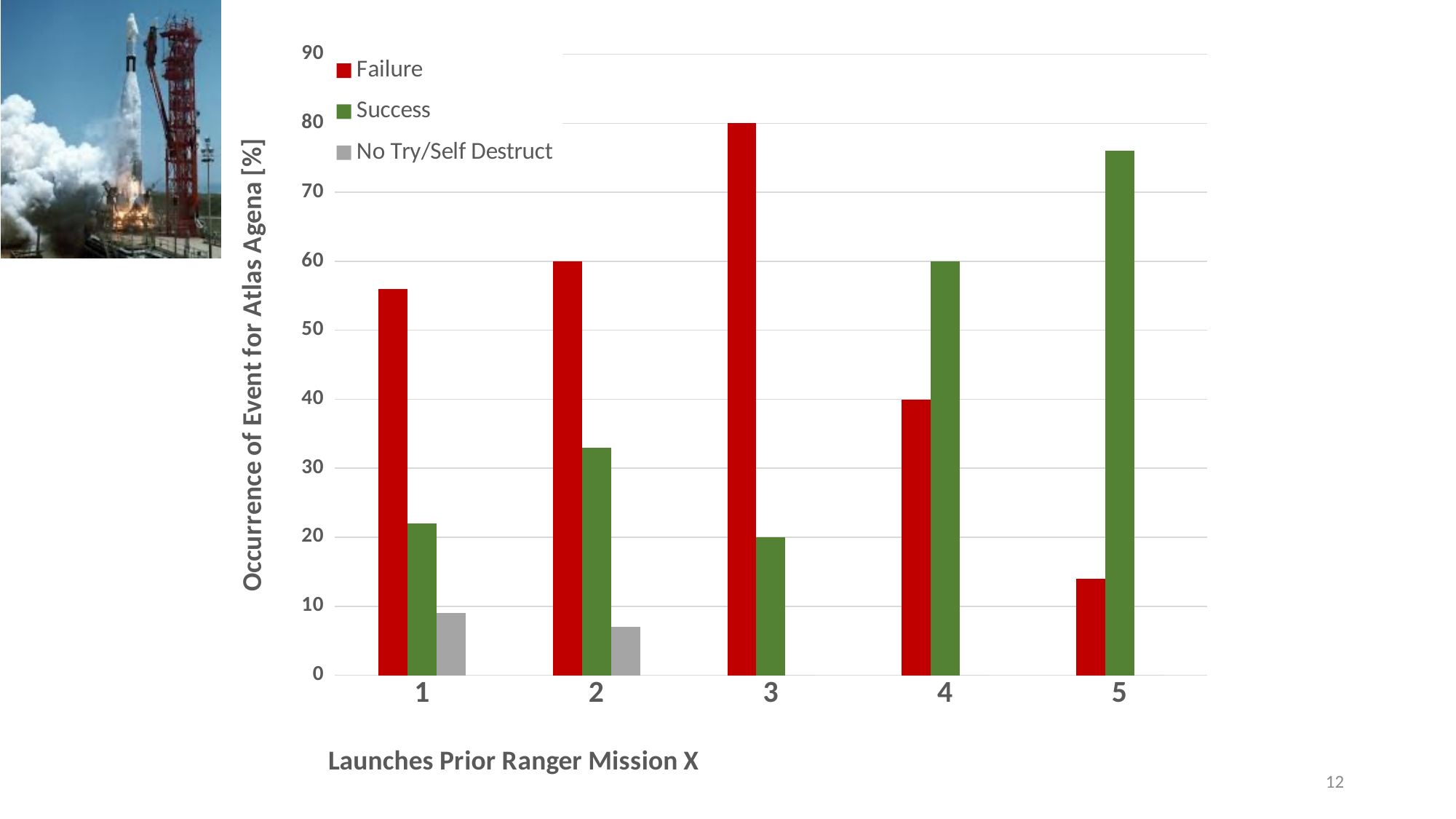
Which category has the highest Failure value? 3 How many series does the legend list? 3 Which category has the highest Success value? 5 What is the title of the x axis? Launches Prior Ranger Mission X What is the Failure value for category 3? 80 Which category has the lowest Failure value? 5 For category 2, which is larger: Failure or Success? Failure For category 4, which is larger: Failure or Success? Success Is the Success value for category 1 greater or less than 30? less How many categories are shown on the x axis? 5 Is the Failure value for category 1 greater or less than 50? greater What kind of chart is shown on the slide? bar chart